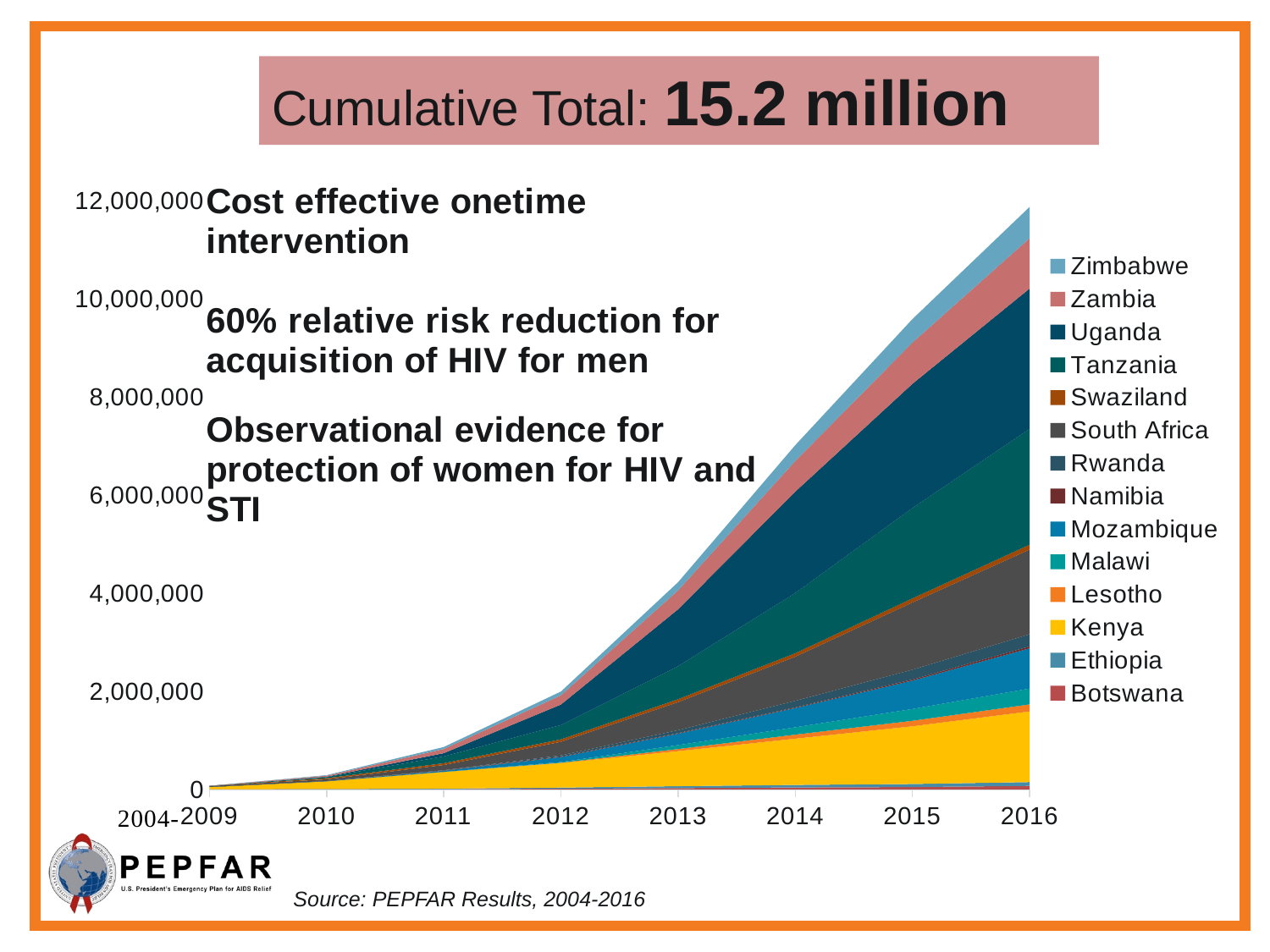
Is the total stacked value in 2015 greater or less than 8,000,000? greater Is the total stacked value in 2014 greater or less than 6,000,000? greater Is the total stacked value in 2011 greater or less than 2,000,000? less In 2016, which contributes more to the stack, Kenya or Zimbabwe? Kenya Does the cumulative total rise or fall from 2004-2009 to 2016? rise How many time periods are shown along the x axis? 8 What kind of chart is shown on the slide? stacked area chart What cumulative total is stated in the slide title? 15.2 million In 2016, which contributes more to the stack, Uganda or Zimbabwe? Uganda Which country is listed first in the legend? Zimbabwe How many countries does the legend list? 14